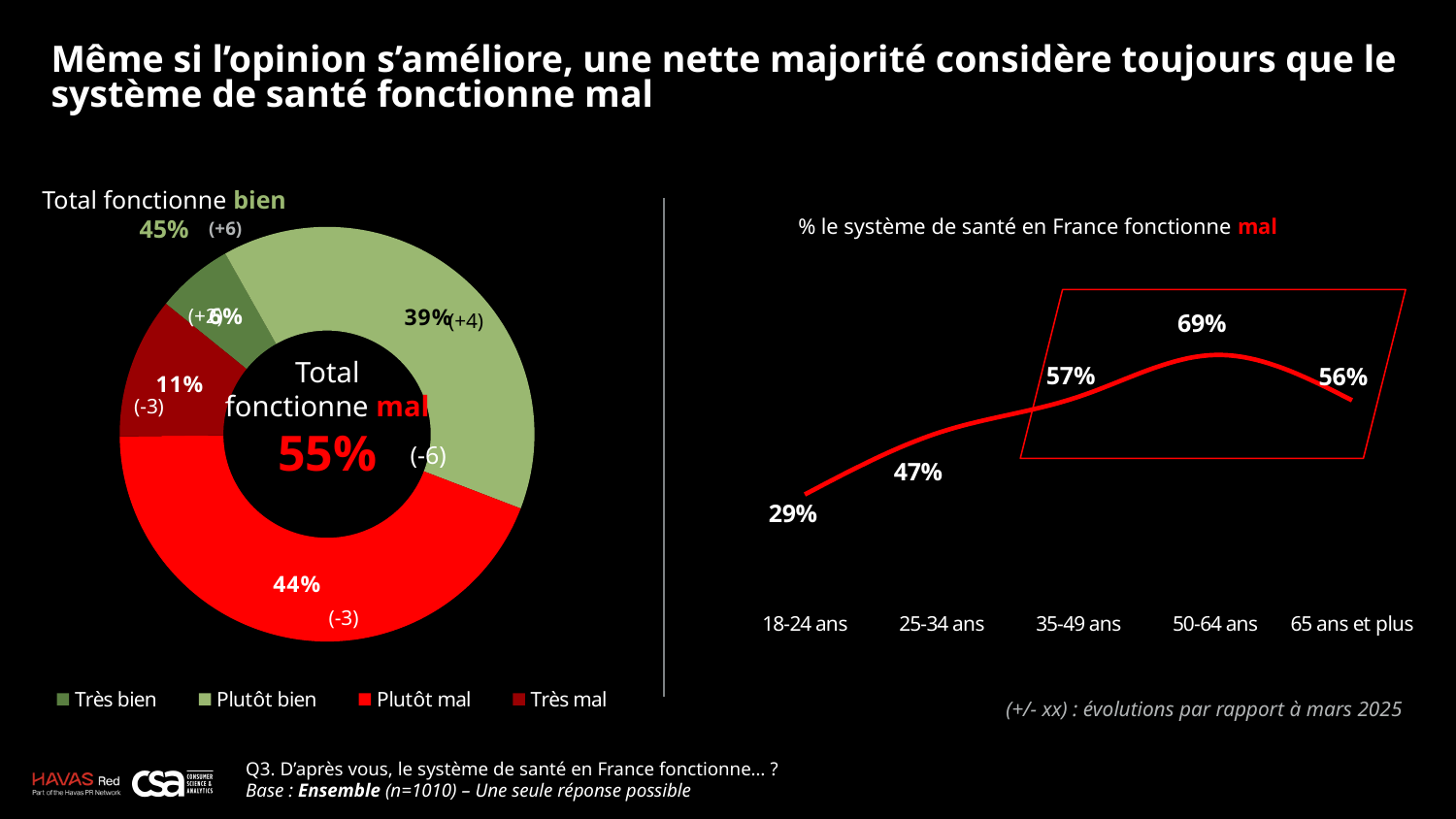
In the line chart on the right, what is the value for 65 ans et plus? 56% In the donut chart on the left, what is the value for Plutôt mal? 44% In the line chart on the right, which age group has the lowest value? 18-24 ans In the line chart on the right, what is the difference between the values for 50-64 ans and 18-24 ans? 40 points In the donut chart on the left, what is the value for Plutôt bien? 39% In the line chart on the right, do the values rise or fall from 18-24 ans to 50-64 ans? rise In the line chart on the right, how many age groups are plotted? 5 In the donut chart on the left, how many entries does the legend list? 4 In the line chart on the right, what is the value for 50-64 ans? 69% In the line chart on the right, what is the value for 18-24 ans? 29% In the donut chart on the left, which is larger, Plutôt mal or Très mal? Plutôt mal In the line chart on the right, which age group has the highest value? 50-64 ans